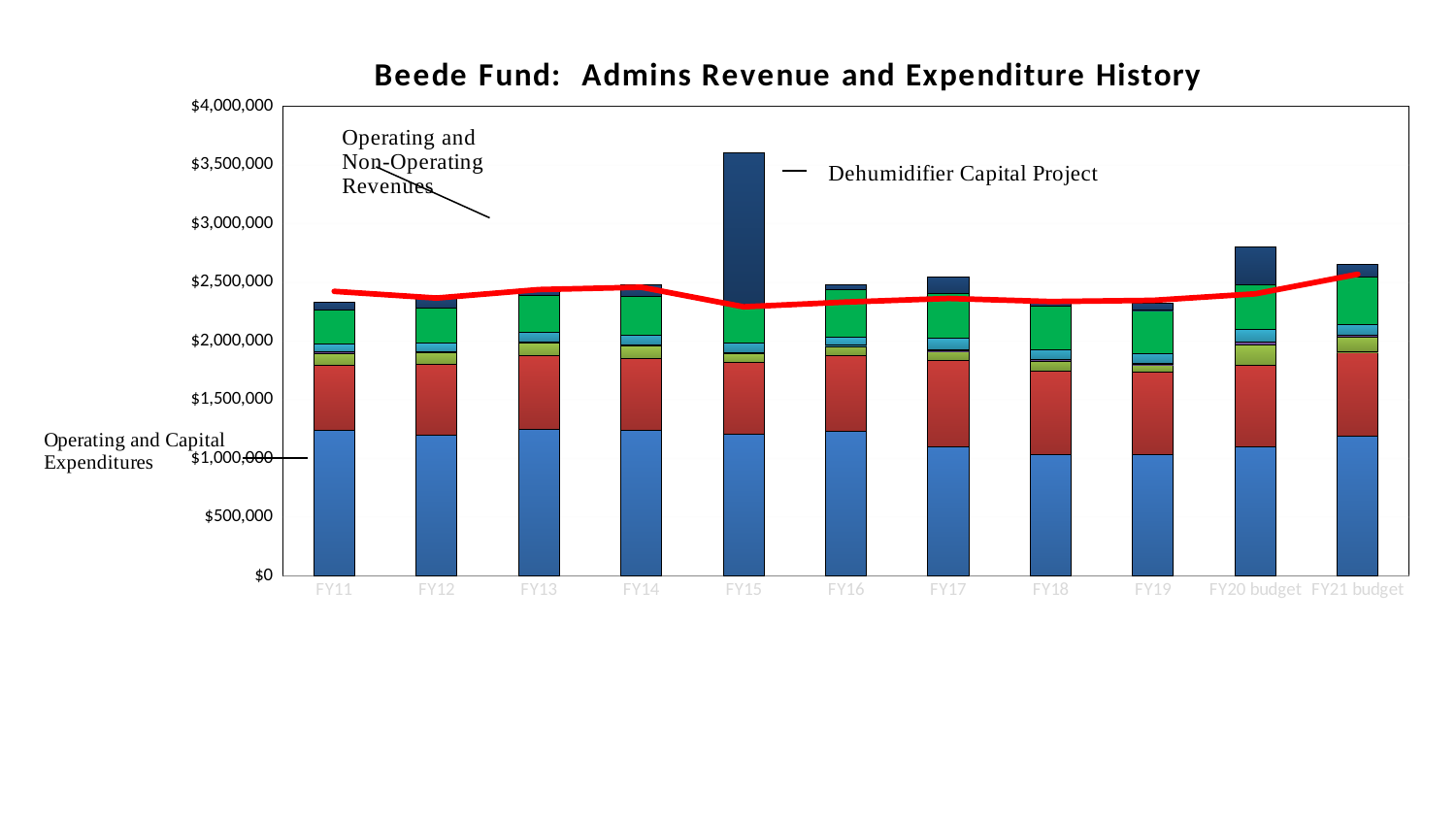
Is the total expenditure bar for FY15 greater or less than $3,500,000? greater What kind of chart is shown on the slide? Stacked bar chart with a line What does the red line on the chart represent? Operating and Non-Operating Revenues Does the revenue line rise or fall from FY19 to FY21 budget? rise Which fiscal year has the tallest expenditure bar? FY15 What does the dark navy segment at the top of the FY15 bar represent? Dehumidifier Capital Project How many fiscal-year categories are shown on the x axis? 11 Which has the taller expenditure bar, FY15 or FY16? FY15 Which has the taller expenditure bar, FY20 budget or FY21 budget? FY20 budget Is the total expenditure bar for FY18 greater or less than $2,500,000? less Is the revenue line value at FY15 greater or less than $2,500,000? less